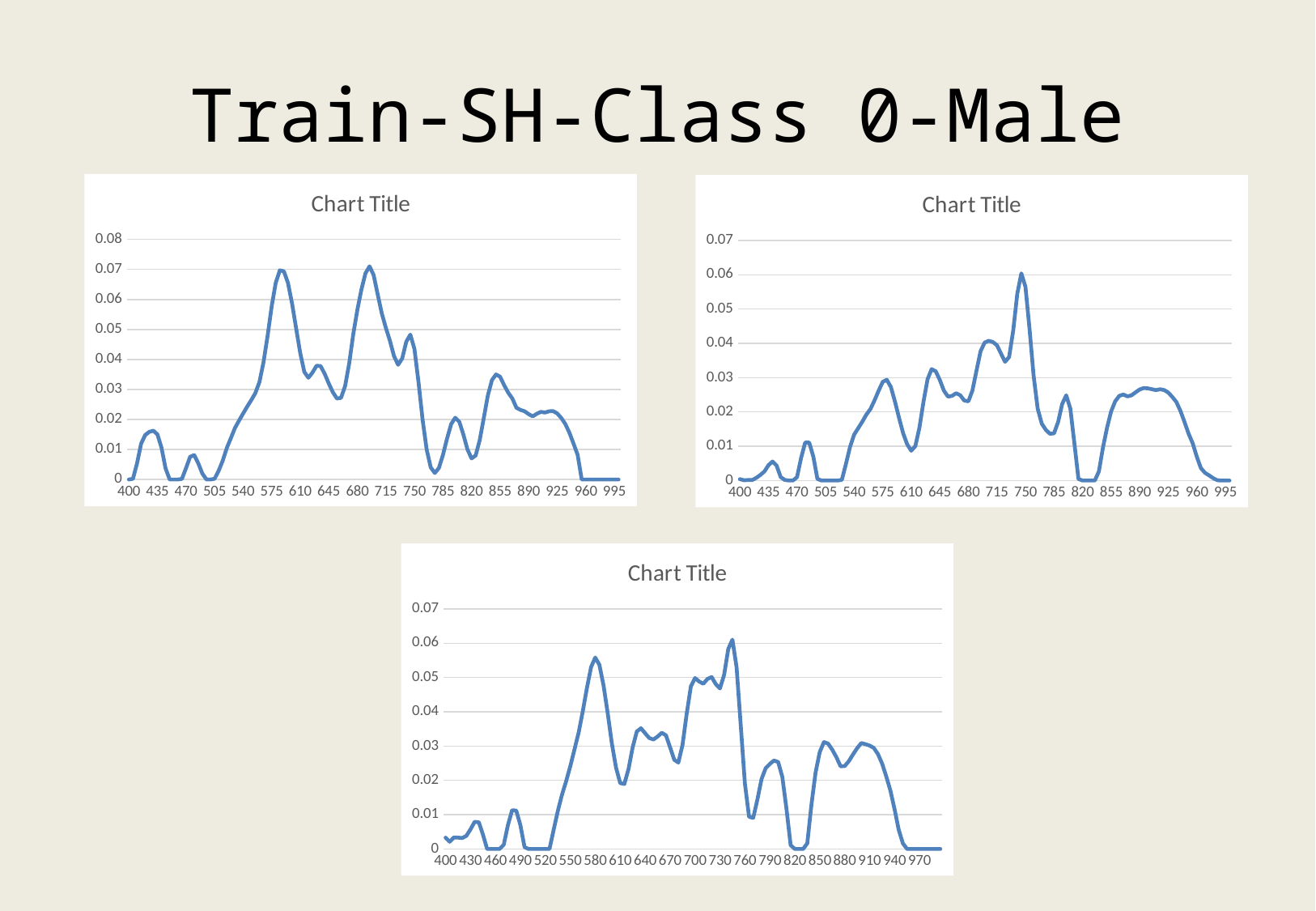
On the top-right chart, is the highest value of the line greater or less than 0.05? greater On the top-right chart, does the line rise or fall between 750 and 785? fall On the bottom chart, is the highest value of the line greater or less than 0.05? greater What kind of chart is the top-left chart? line chart On the top-left chart, is the highest value of the line greater or less than 0.06? greater On the top-left chart, what is the value at 400? 0 What kind of chart is the bottom chart? line chart What is the highest value shown on the y axis of the top-left chart? 0.08 What is the title shown on the top-right chart? Chart Title